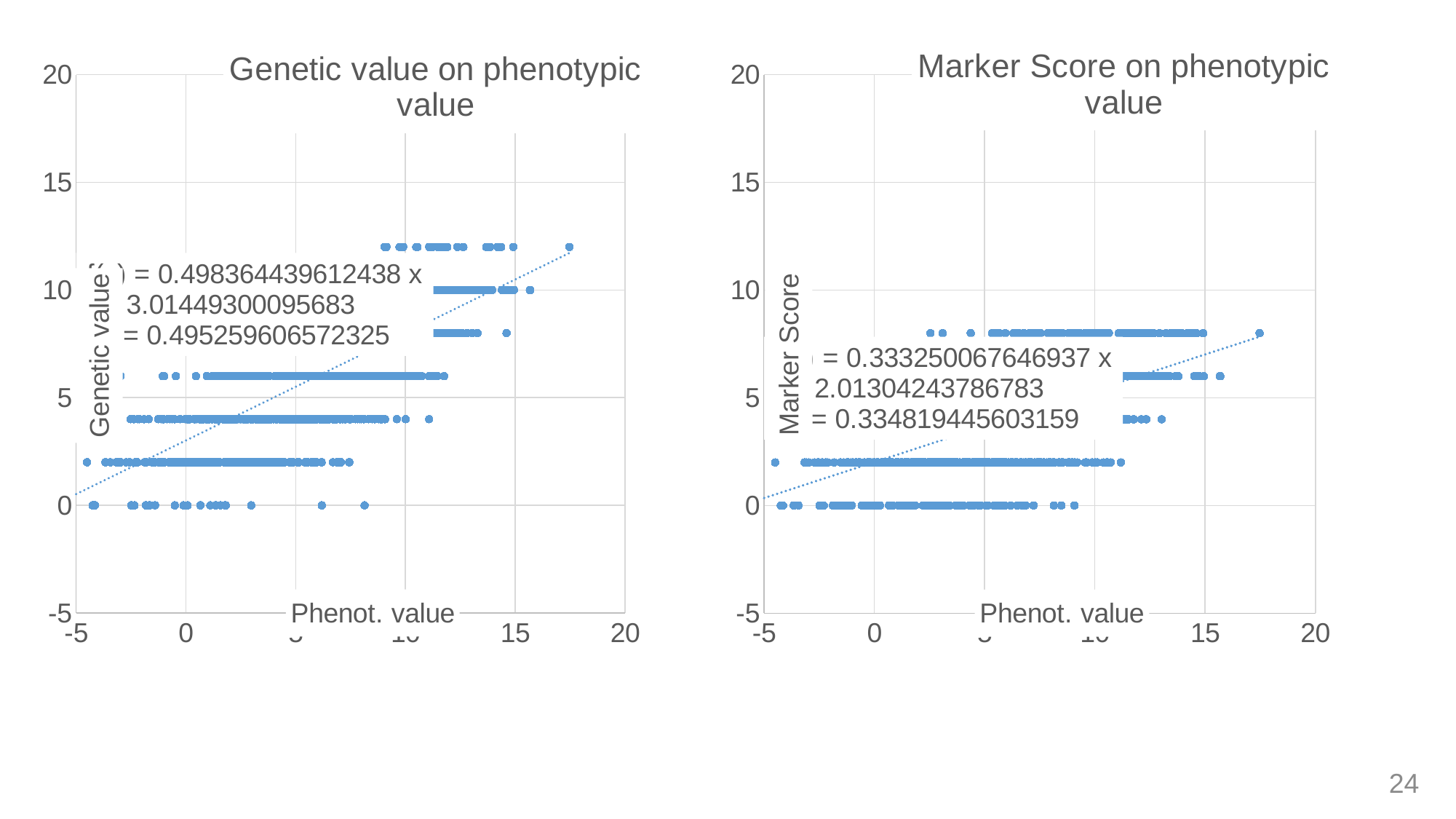
What is the maximum value shown on the y-axis of the left chart, 'Genetic value on phenotypic value'? 20 In the left chart, 'Genetic value on phenotypic value', what R² value is printed? 0.495259606572325 What kind of chart is the left chart, 'Genetic value on phenotypic value'? Scatter chart In the left chart, 'Genetic value on phenotypic value', is the highest plotted Genetic value greater or less than 10? greater In the right chart, 'Marker Score on phenotypic value', do the Marker Score values tend to rise or fall as phenotypic value increases? Rise In the right chart, 'Marker Score on phenotypic value', is the highest plotted Marker Score greater or less than 10? less In the right chart, 'Marker Score on phenotypic value', what R² value is printed? 0.334819445603159 In the left chart, 'Genetic value on phenotypic value', what is the slope of the fitted trendline equation? 0.498364439612438 What is the y-axis title of the right chart, 'Marker Score on phenotypic value'? Marker Score In the right chart, 'Marker Score on phenotypic value', what is the lowest Marker Score plotted? 0 Which chart has the higher R² value, 'Genetic value on phenotypic value' or 'Marker Score on phenotypic value'? Genetic value on phenotypic value In the right chart, 'Marker Score on phenotypic value', what is the slope of the fitted trendline equation? 0.333250067646937